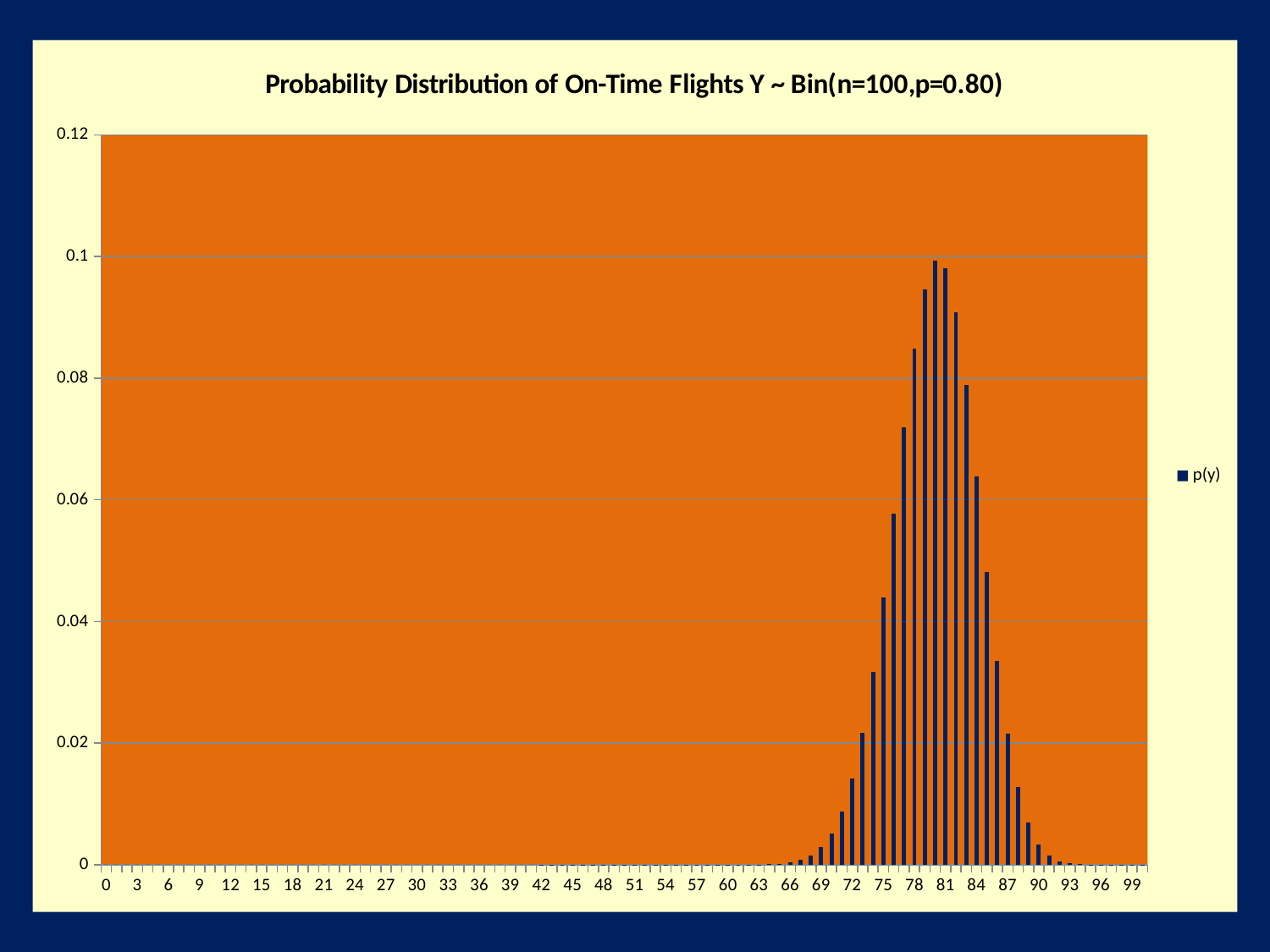
What kind of chart is shown on the slide? bar chart Do the values rise or fall along the x axis from 84 to 93? fall Is the value for 30 greater or less than 0.02? less Is the value for 87 greater or less than 0.04? less What is the title of the chart? Probability Distribution of On-Time Flights Y ~ Bin(n=100,p=0.80) Which has the larger value, 75 or 87? 75 How many series does the legend list? 1 Is the value for 72 greater or less than 0.02? less What series name appears in the legend? p(y) Which has the larger value, 78 or 84? 78